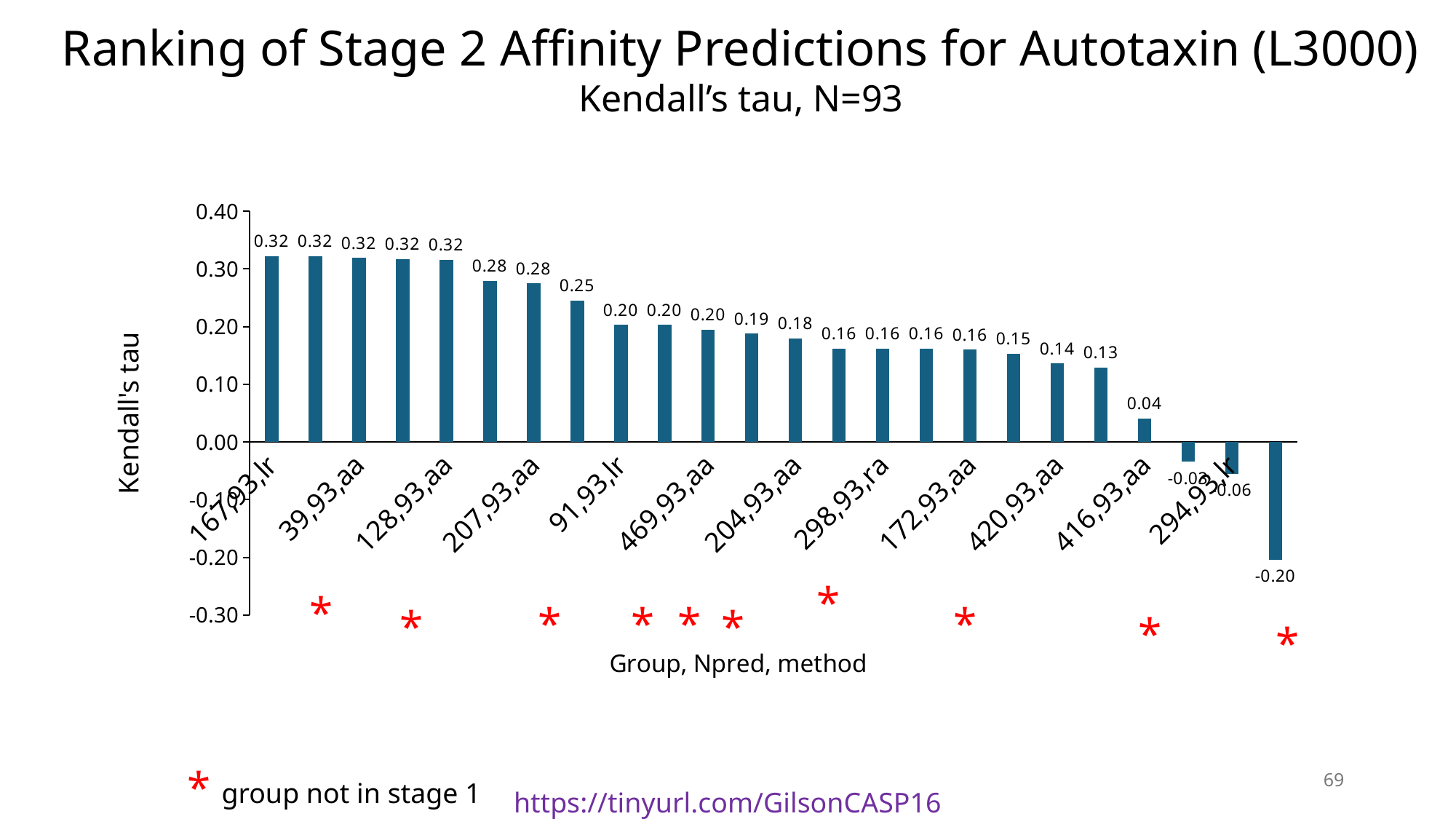
What is the Kendall's tau value for 207,93,aa? 0.28 What is the highest Kendall's tau value shown in the chart? 0.32 What type of chart is shown on the slide? bar chart What is the difference in Kendall's tau between 207,93,aa and 91,93,lr? 0.08 What is the Kendall's tau value for 416,93,aa? 0.04 Do the Kendall's tau values rise or fall from left to right along the x axis? fall Which has a higher Kendall's tau, 128,93,aa or 420,93,aa? 128,93,aa What is the Kendall's tau value for 167,93,lr? 0.32 What is the Kendall's tau value for 294,93,lr? -0.06 How many bars are plotted in the chart? 24 What is the Kendall's tau value for 91,93,lr? 0.20 What is the lowest Kendall's tau value shown in the chart? -0.20